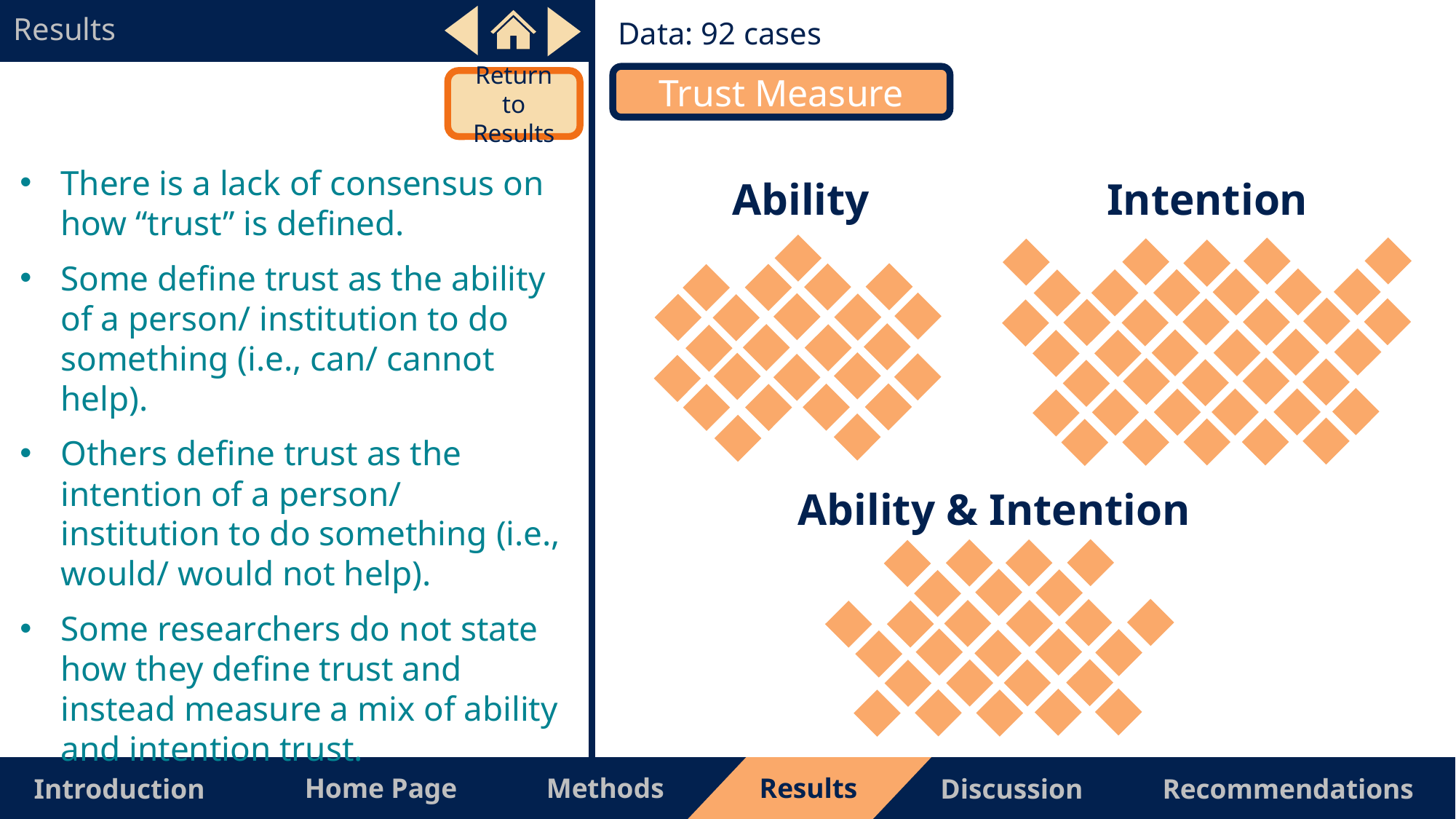
What is the title shown above the chart? Trust Measure Which has more icons, Ability or Intention? Intention How many cases does the chart's data cover, according to the slide? 92 cases Which trust measure category has the most icons? Intention What kind of chart is used to show the Trust Measure data? pictograph (icon chart) How many trust measure categories are shown in the chart? 3